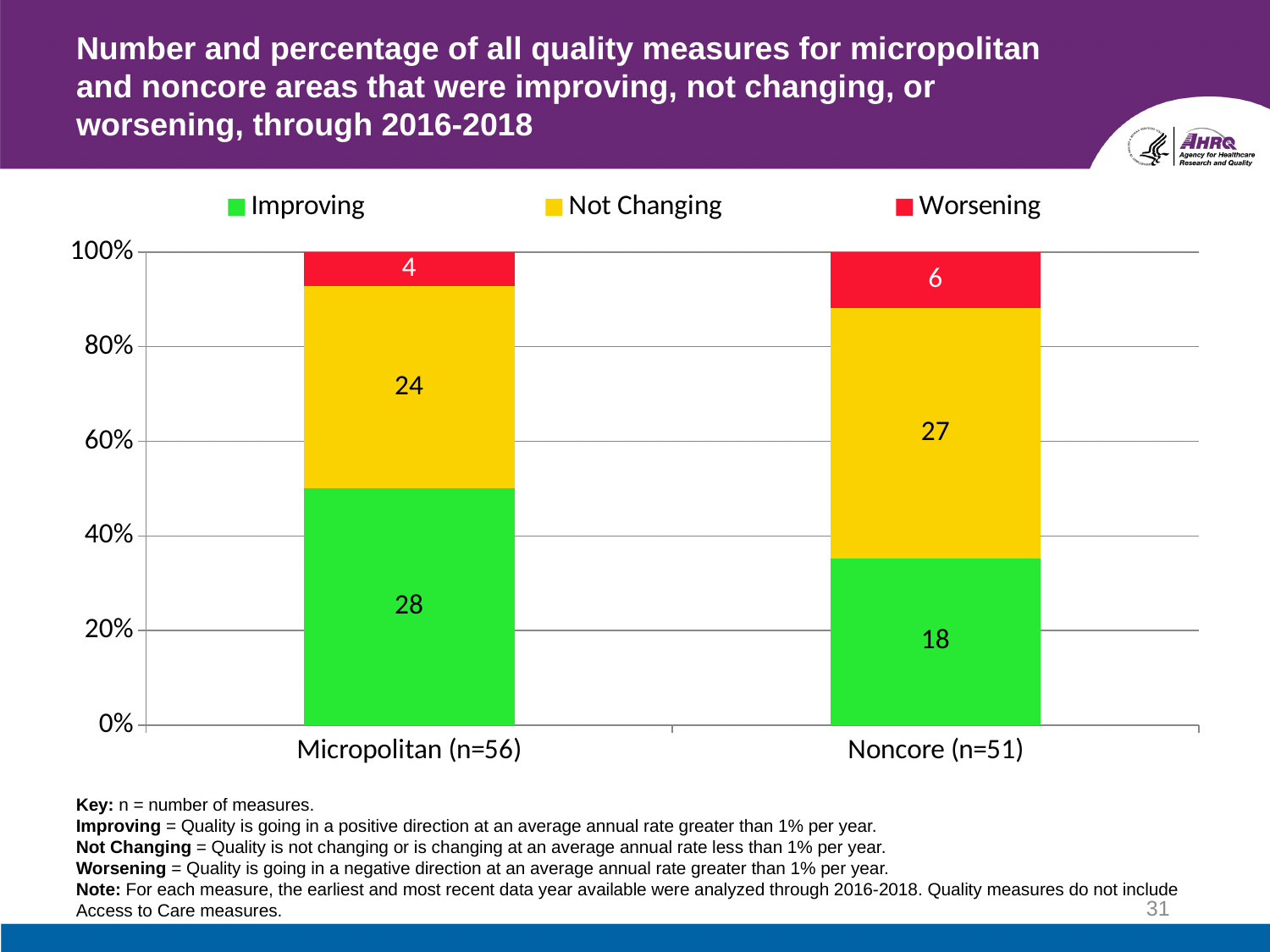
How many quality measures were improving for Micropolitan (n=56)? 28 Which colour represents the Worsening series in the legend? Red What is the total number of measures in the Micropolitan bar? 56 How many quality measures were worsening for Micropolitan (n=56)? 4 What is the total number of measures in the Noncore bar? 51 What is the difference between the number of not changing measures for Noncore and Micropolitan? 3 Which area had more improving measures, Micropolitan or Noncore? Micropolitan How many area categories are shown on the x axis? 2 How many quality measures were not changing for Noncore (n=51)? 27 How many series does the legend list? 3 What kind of chart is shown on the slide? Stacked bar chart How many quality measures were worsening for Noncore (n=51)? 6